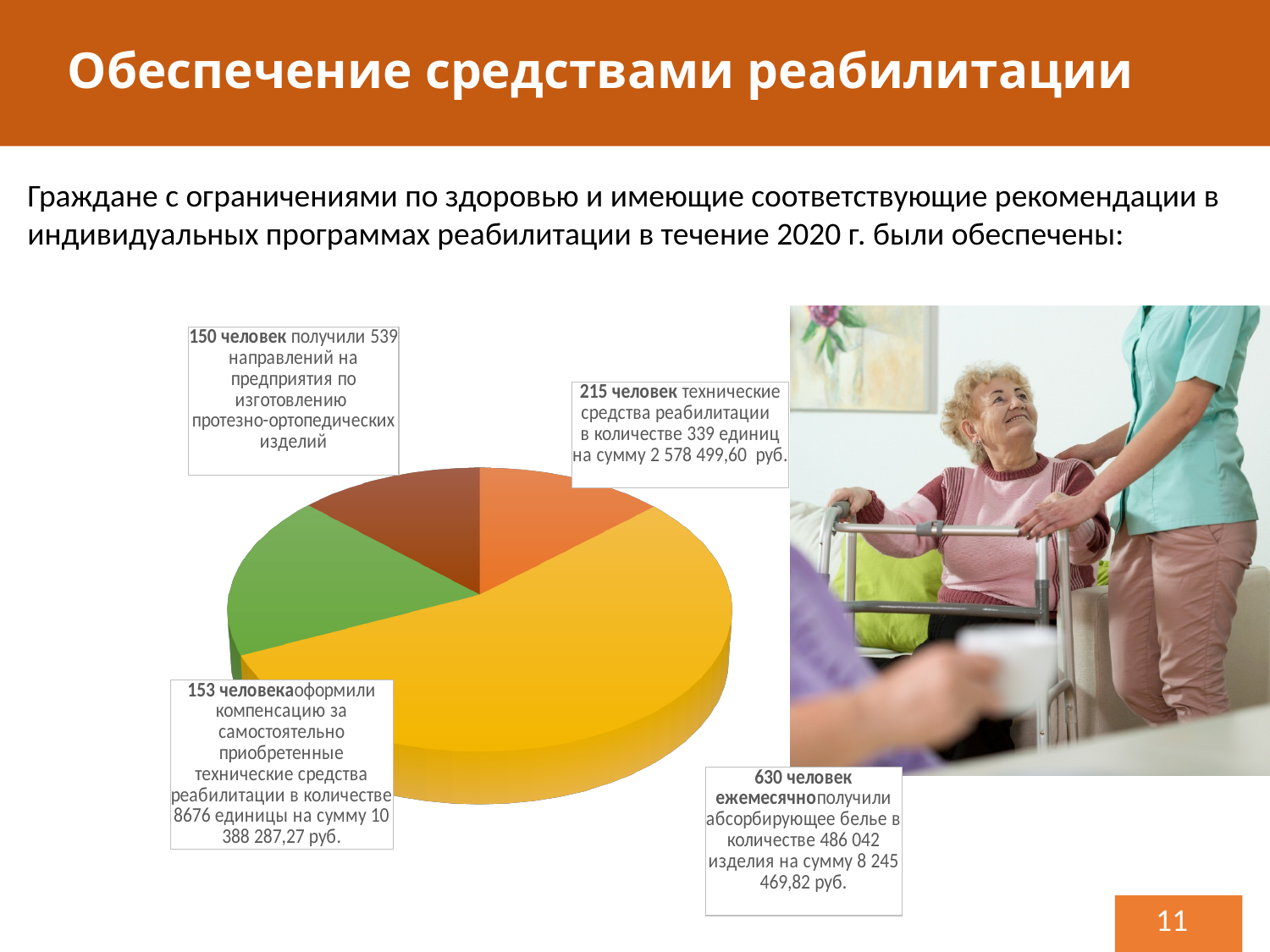
What is the difference between the number of people who received technical means of rehabilitation (215) and those who received referrals for prosthetic-orthopedic products (150)? 65 What was the total sum of compensation for independently purchased technical means of rehabilitation? 10 388 287,27 руб. How many people received technical means of rehabilitation (технические средства реабилитации) according to the chart? 215 человек How many slices does the pie chart have? 4 How many units of absorbent underwear were provided according to the chart label? 486 042 What colour is the largest slice of the pie chart? yellow Which group of citizens is the largest slice of the pie chart? 630 человек ежемесячно получили абсорбирующее белье Which is larger: the number of people who received absorbent underwear or the number who received technical means of rehabilitation? absorbent underwear (630 человек) Which group of citizens is the smallest slice of the pie chart? 150 человек получили 539 направлений на предприятия по изготовлению протезно-ортопедических изделий How many more people received absorbent underwear monthly than received technical means of rehabilitation? 415 How many people received compensation for independently purchased technical means of rehabilitation? 153 человека What kind of chart is shown on the slide? pie chart